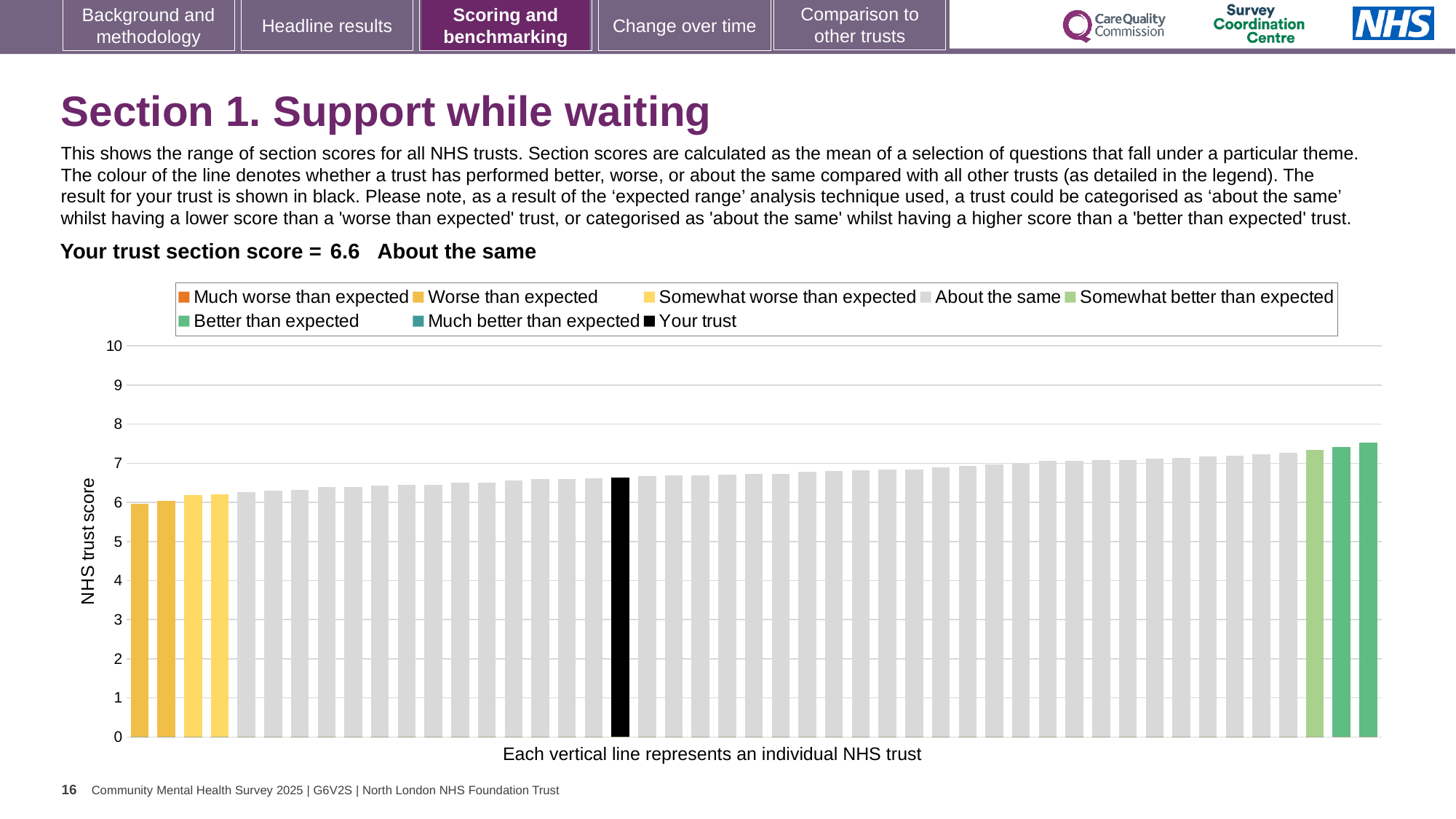
What category is your trust placed in according to the text above the chart? About the same Do the bar values rise or fall from left to right along the x axis? rise How many bars are coloured as 'Worse than expected' (dark yellow)? 2 How many bars are coloured as 'Better than expected' (green)? 2 Is the value of the tallest bar in the chart greater or less than 8? less Is the value for your trust (the black bar) greater or less than 5? greater What is the section score for your trust shown on the slide? 6.6 Is the value of the shortest bar in the chart greater or less than 5? greater How many entries does the chart legend list? 8 What kind of chart is shown on the slide? Bar chart What is the label of the vertical axis? NHS trust score